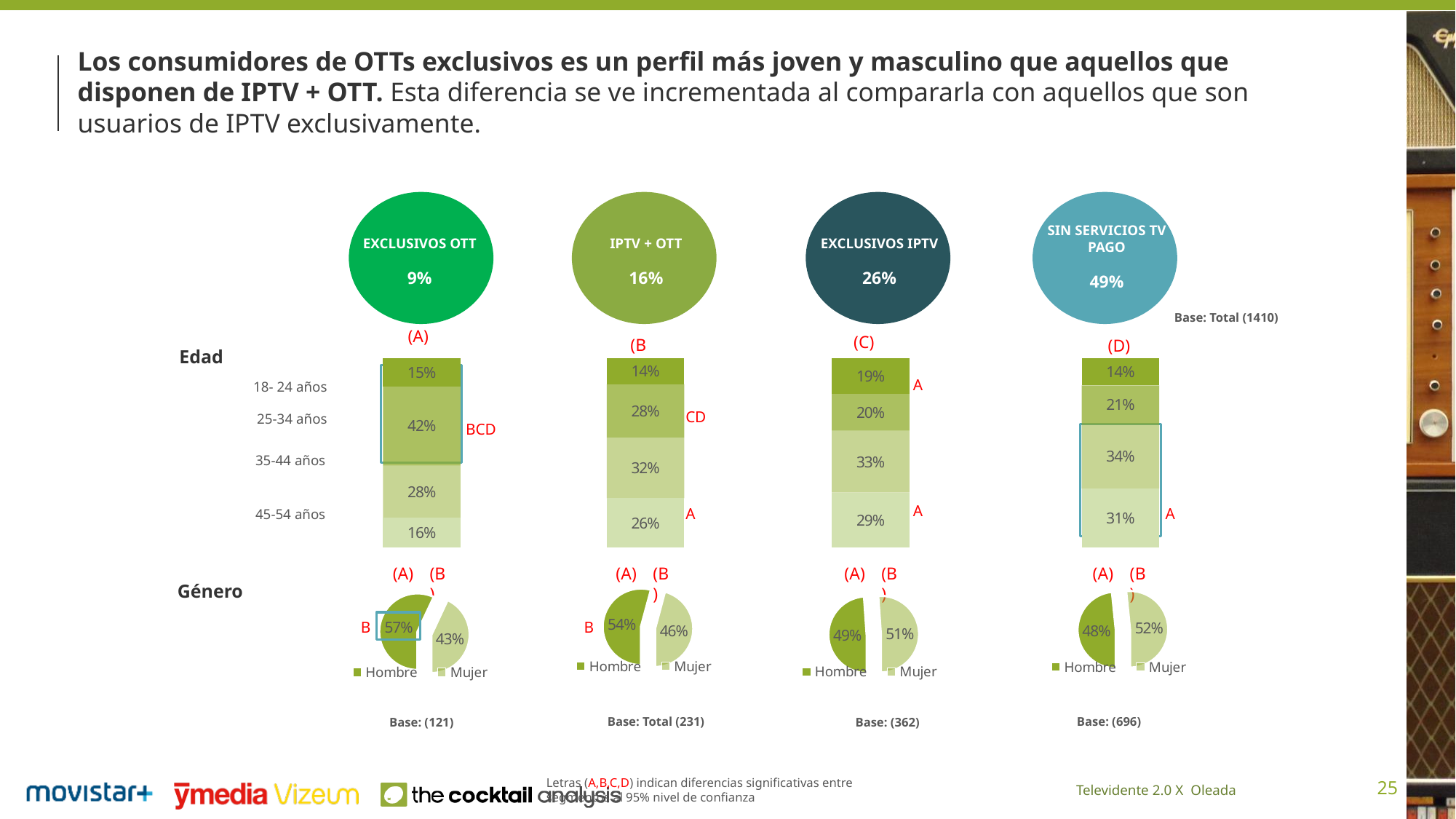
In the Género pie chart for SIN SERVICIOS TV PAGO, what share is Mujer? 52% In the Género pie chart for IPTV + OTT, which is larger, Hombre or Mujer? Hombre In the Edad stacked bar for EXCLUSIVOS IPTV, what is the value for 18-24 años? 19% What is the difference between the 25-34 años values for EXCLUSIVOS OTT and IPTV + OTT in the Edad bars? 14 percentage points In the Edad stacked bar for SIN SERVICIOS TV PAGO, what is the value for 45-54 años? 31% What kind of chart is used for the Edad section? Stacked bar chart In the Género pie chart for EXCLUSIVOS OTT, what share is Hombre? 57% In the Edad stacked bar for SIN SERVICIOS TV PAGO, which age group has the lowest value? 18-24 años In the Edad stacked bar for EXCLUSIVOS OTT, what is the value for 25-34 años? 42% In the Edad stacked bar for IPTV + OTT, what is the value for 35-44 años? 32% How many series does the legend of each Género pie chart list? 2 In the Edad stacked bar for EXCLUSIVOS OTT, which age group has the highest value? 25-34 años